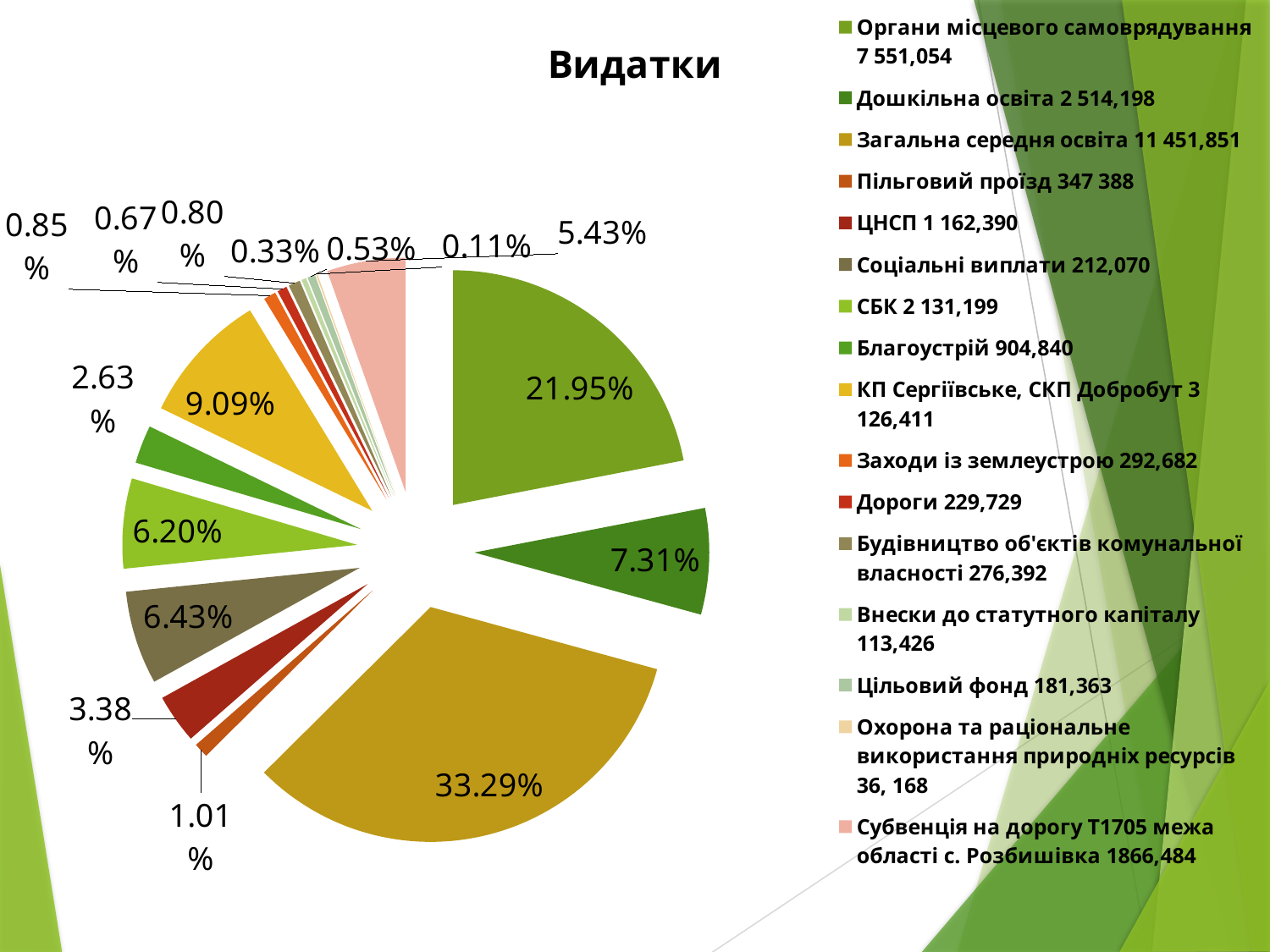
What percentage is shown for Благоустрій? 2.63% How many categories does the legend of the pie chart list? 16 What percentage is shown for Органи місцевого самоврядування? 21.95% What is the difference in percentage points between the Загальна середня освіта slice and the Органи місцевого самоврядування slice? 11.34 Which slice is larger: Дошкільна освіта or СБК? Дошкільна освіта What share of the pie does Загальна середня освіта have? 33.29% What is the title of the chart? Видатки What percentage is shown for Субвенція на дорогу Т1705 межа області с. Розбишівка? 5.43% What percentage is shown for КП Сергіївське, СКП Добробут? 9.09% What type of chart is shown on the slide? Pie chart Which category has the largest slice of the pie? Загальна середня освіта Which category has the smallest slice of the pie? Охорона та раціональне використання природніх ресурсів